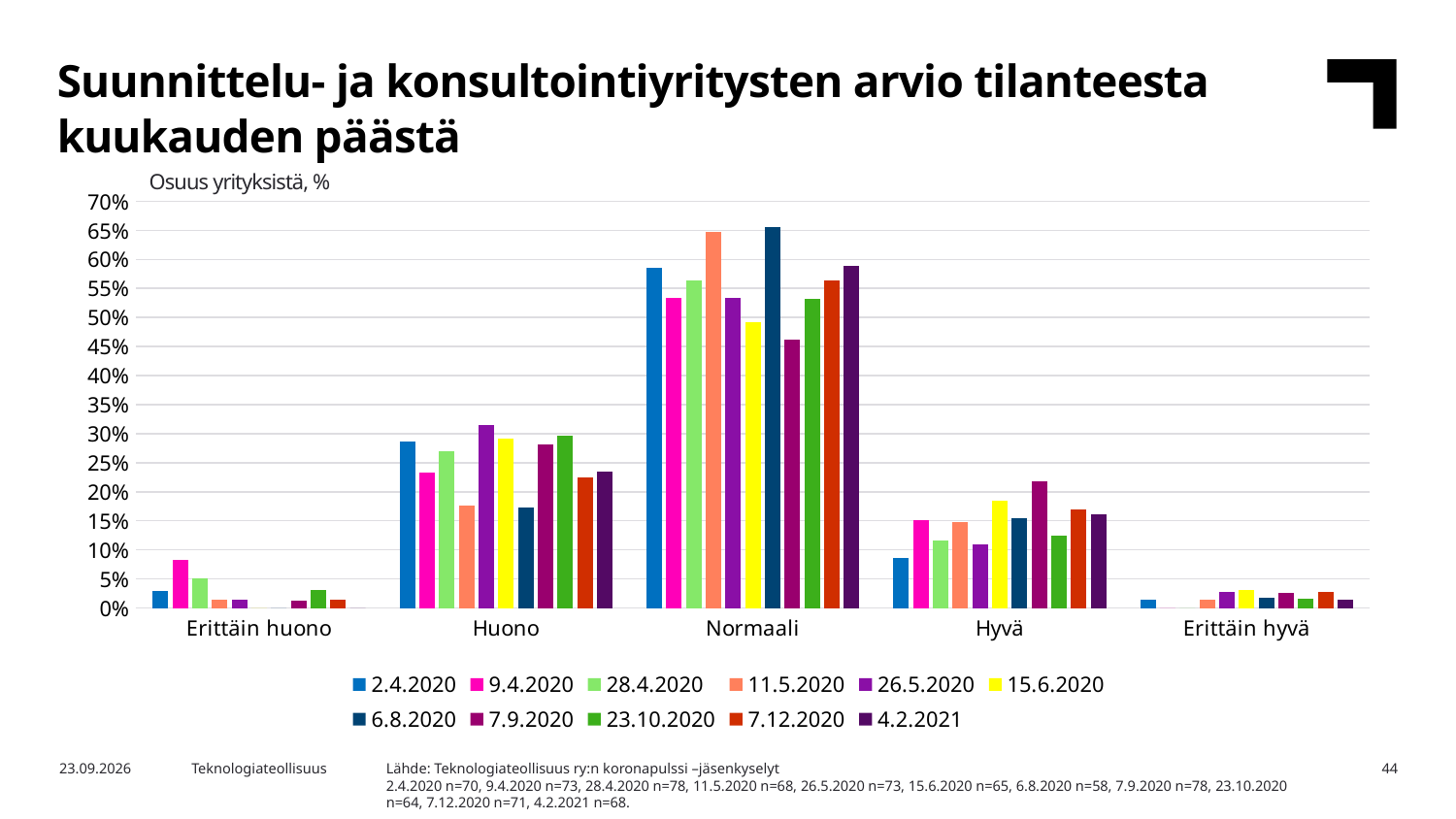
How many series does the chart legend list? 11 Is the value for Erittäin huono in the 9.4.2020 series greater or less than 10%? less Is the value for Huono in the 2.4.2020 series greater or less than 25%? greater Within the Normaali category, which series has the lowest value? 7.9.2020 Within the Hyvä category, which series has the highest value? 7.9.2020 For the 6.8.2020 series, which category has the highest value? Normaali Is the value for Hyvä in the 15.6.2020 series greater or less than 15%? greater What kind of chart is shown on the slide? bar chart How many categories are shown on the x axis of the chart? 5 What label is shown above the y axis of the chart? Osuus yrityksistä, % For the Hyvä category, which is larger: the 7.9.2020 value or the 2.4.2020 value? 7.9.2020